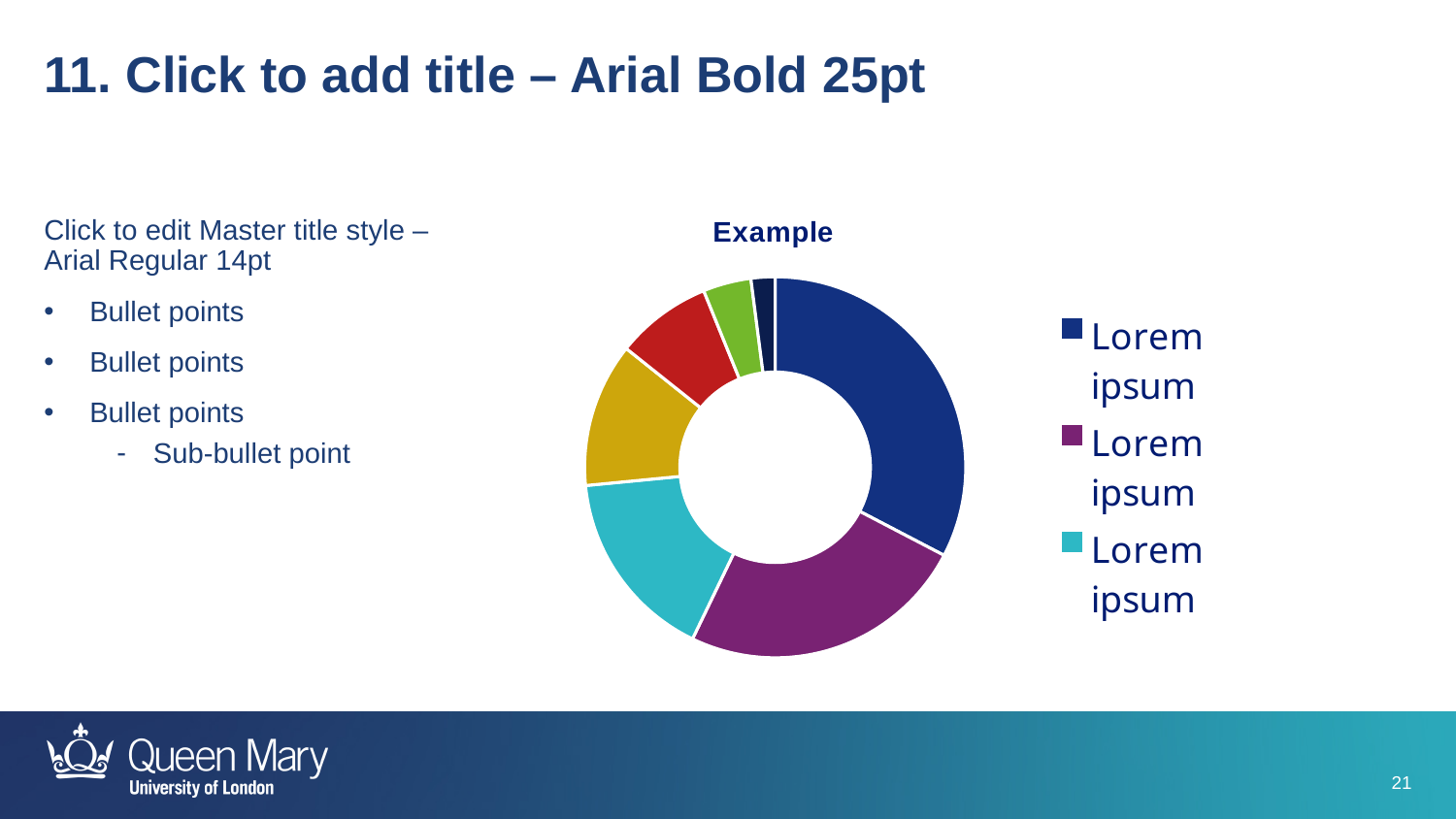
Which colour slice is the smallest in the doughnut chart? dark navy Which colour slice is the largest in the doughnut chart? dark blue What is the title of the chart? Example Which is larger, the purple slice or the cyan slice? purple What text is used for each legend entry of the chart? Lorem ipsum What kind of chart is shown on the slide? doughnut chart How many slices does the doughnut chart have? 7 How many entries does the chart's legend list? 3 Which is larger, the gold slice or the red slice? gold